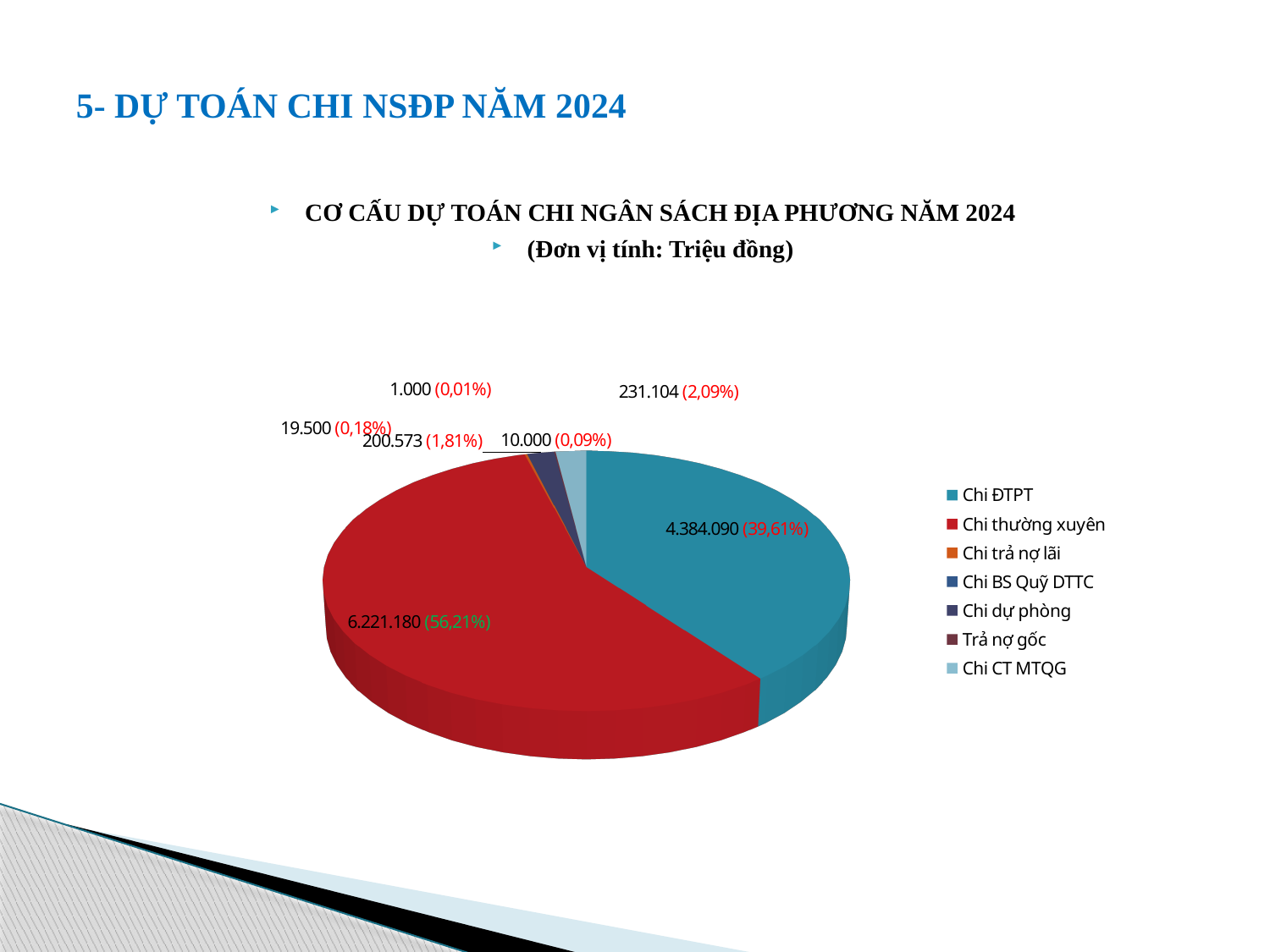
What is the value shown for Chi thường xuyên? 6.221.180 How many categories does the legend of the pie chart list? 7 What is the difference between the values for Chi thường xuyên and Chi ĐTPT? 1.837.090 What is the smallest percentage printed on the pie chart? 0,01% Which category has the largest slice of the pie? Chi thường xuyên What share of the pie does Chi thường xuyên represent? 56,21% What kind of chart is shown on the slide? Pie chart What is the value shown for Chi ĐTPT? 4.384.090 What unit of measurement is stated for the chart? Triệu đồng Which is larger, Chi ĐTPT or Chi thường xuyên? Chi thường xuyên What is the title given above the pie chart? CƠ CẤU DỰ TOÁN CHI NGÂN SÁCH ĐỊA PHƯƠNG NĂM 2024 What share of the pie does Chi ĐTPT represent? 39,61%